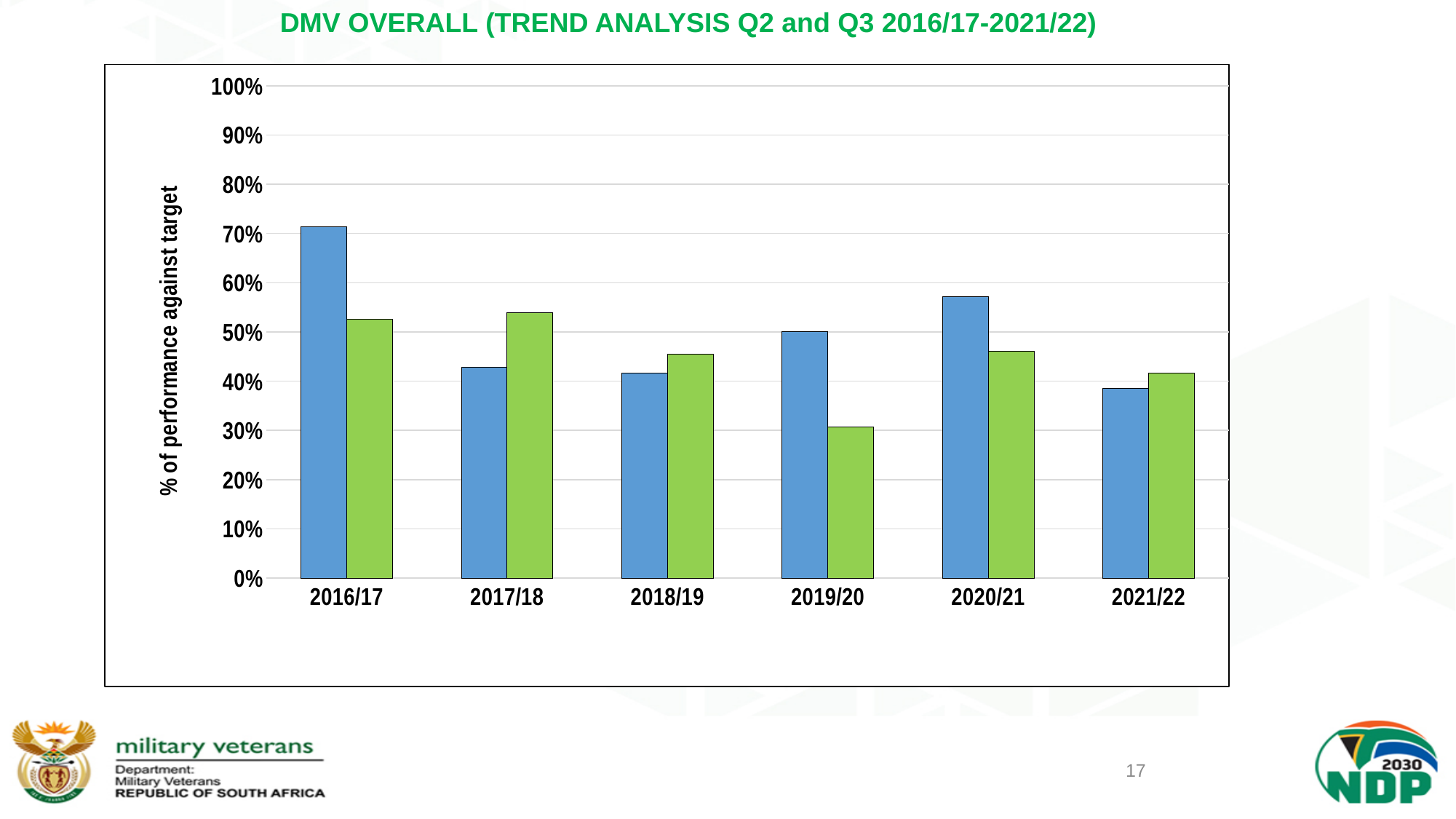
In which year is the blue bar the highest? 2016/17 What is the title of the slide? DMV OVERALL (TREND ANALYSIS Q2 and Q3 2016/17-2021/22) Is the value of the blue bar for 2016/17 greater or less than 60%? greater Is the value of the green bar for 2019/20 greater or less than 40%? less Do the blue bars rise or fall from 2016/17 to 2018/19? fall How many financial years are shown on the x axis of the chart? 6 In which year is the green bar the lowest? 2019/20 What kind of chart is shown on the slide? bar chart In 2017/18, which bar is taller, the blue bar or the green bar? green In 2019/20, which bar is taller, the blue bar or the green bar? blue What is the title of the chart's vertical axis? % of performance against target Is the value of the blue bar for 2021/22 greater or less than 50%? less